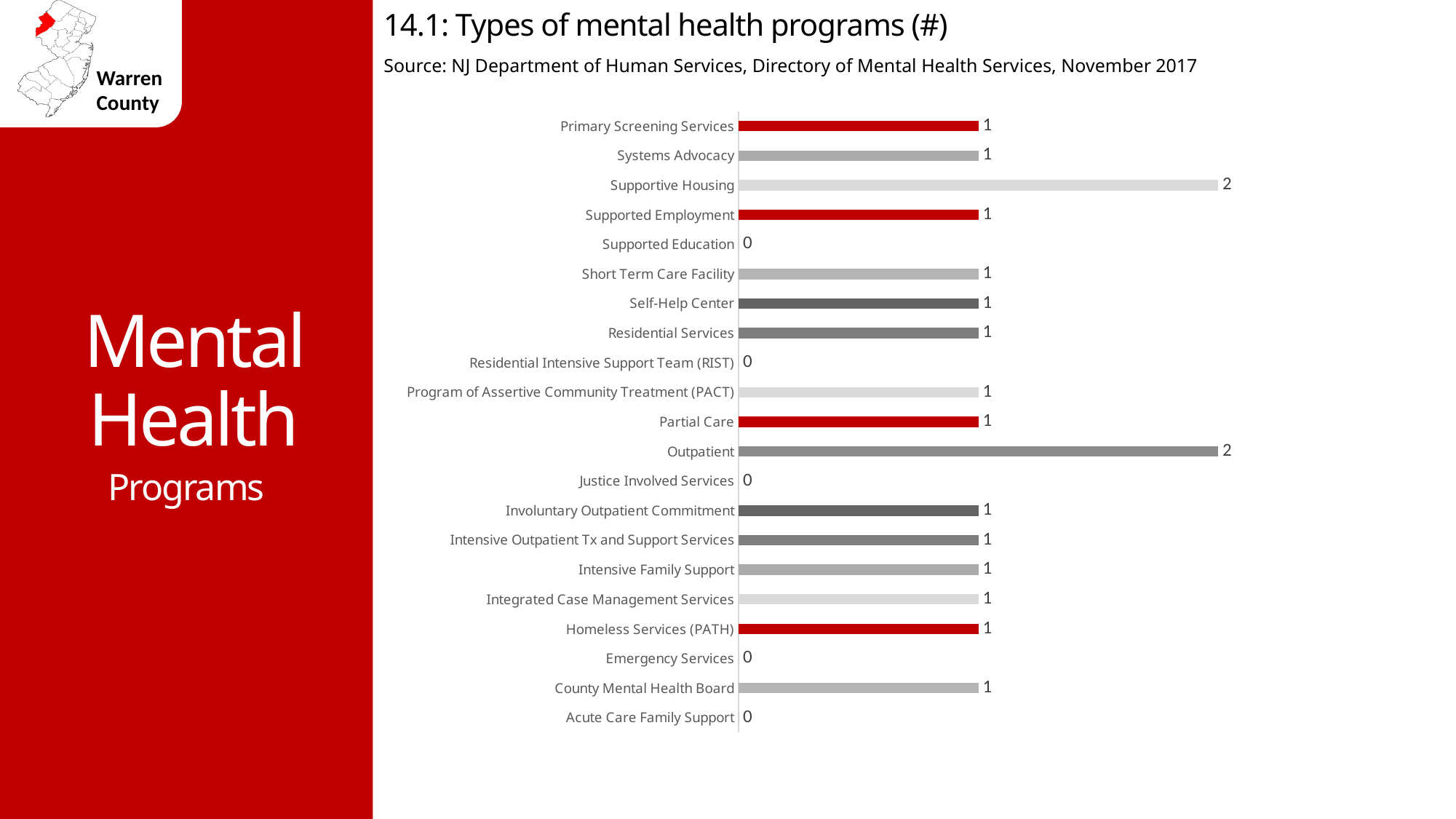
What is the value for Homeless Services (PATH)? 1 What type of chart is shown on the slide? Bar chart What is the difference between the values for Outpatient and Partial Care? 1 What is the value for Supportive Housing? 2 How many categories are plotted in the chart? 21 Which is larger, the value for Supportive Housing or the value for Systems Advocacy? Supportive Housing Which two categories share the highest value in the chart? Supportive Housing and Outpatient What is the value for Emergency Services? 0 What is the value for Supported Education? 0 What is the title of the chart? 14.1: Types of mental health programs (#) What is the value for Outpatient? 2 How many categories have a value of 0? 5